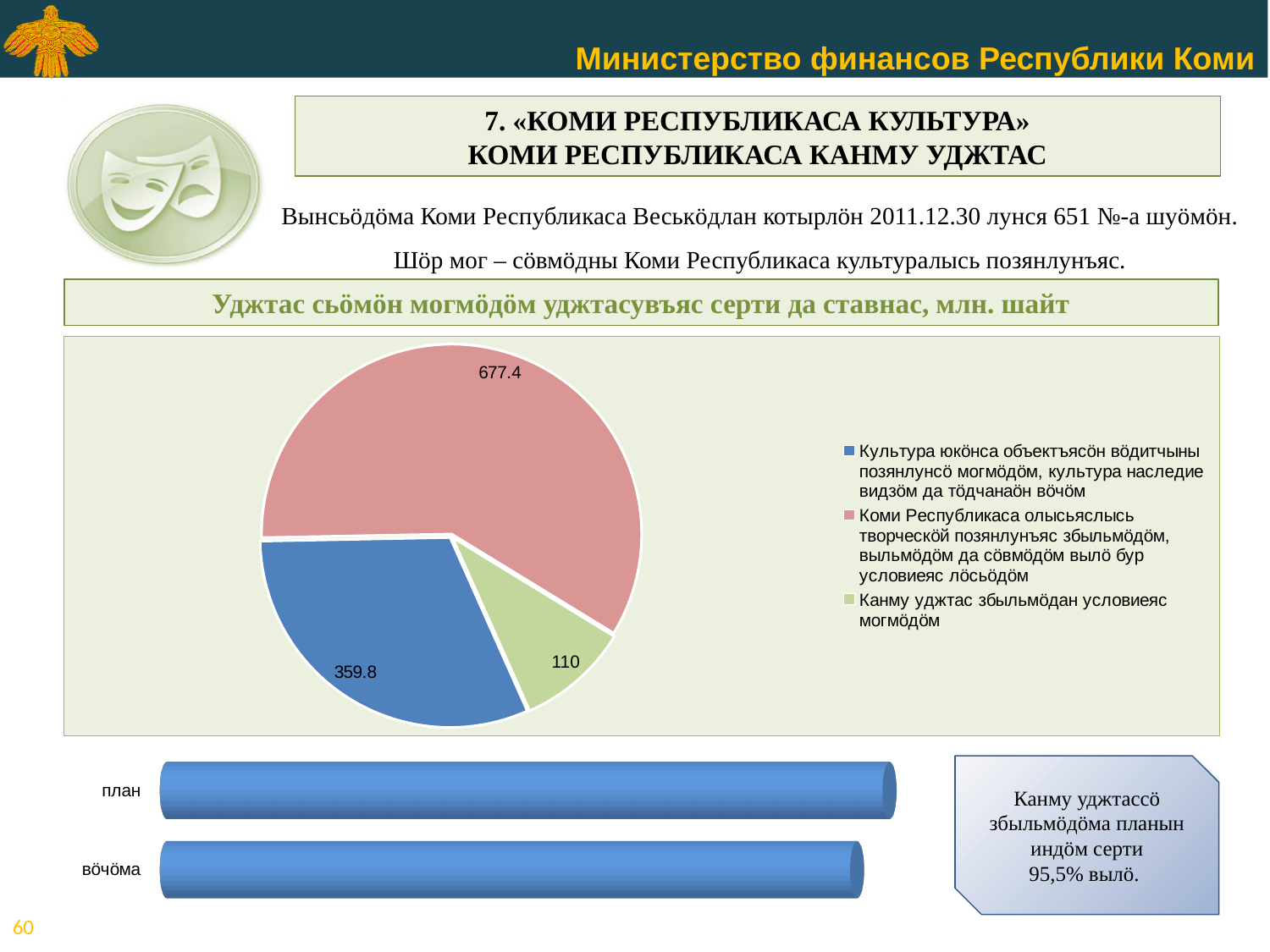
What kind of chart is the bottom chart on the slide? Bar chart In the pie chart, what is the value for the slice "Культура юкӧнса объектъясӧн вӧдитчыны позянлунсӧ могмӧдӧм, культура наследие видзӧм да тӧдчанаӧн вӧчӧм"? 359.8 In the pie chart, what is the value for the slice labelled "Канму уджтас збыльмӧдан условиеяс могмӧдӧм"? 110 In the pie chart, how many entries does the legend list? 3 In the pie chart, which slice has the smallest value? Канму уджтас збыльмӧдан условиеяс могмӧдӧм In the pie chart, what is the difference between the slice valued 359.8 and the slice valued 110? 249.8 In the pie chart, which slice has the largest value? Коми Республикаса олысьяслысь творческӧй позянлунъяс збыльмӧдӧм, выльмӧдӧм да сӧвмӧдӧм вылӧ бур условиеяс лӧсьӧдӧм What kind of chart is the top chart on the slide? Pie chart In the bottom chart, which bar is longer, "план" or "вӧчӧма"? план In the pie chart, what is the value for the slice "Коми Республикаса олысьяслысь творческӧй позянлунъяс збыльмӧдӧм, выльмӧдӧм да сӧвмӧдӧм вылӧ бур условиеяс лӧсьӧдӧм"? 677.4 In the pie chart, how many slices are there? 3 In the pie chart, what is the difference between the largest slice (677.4) and the slice valued 359.8? 317.6